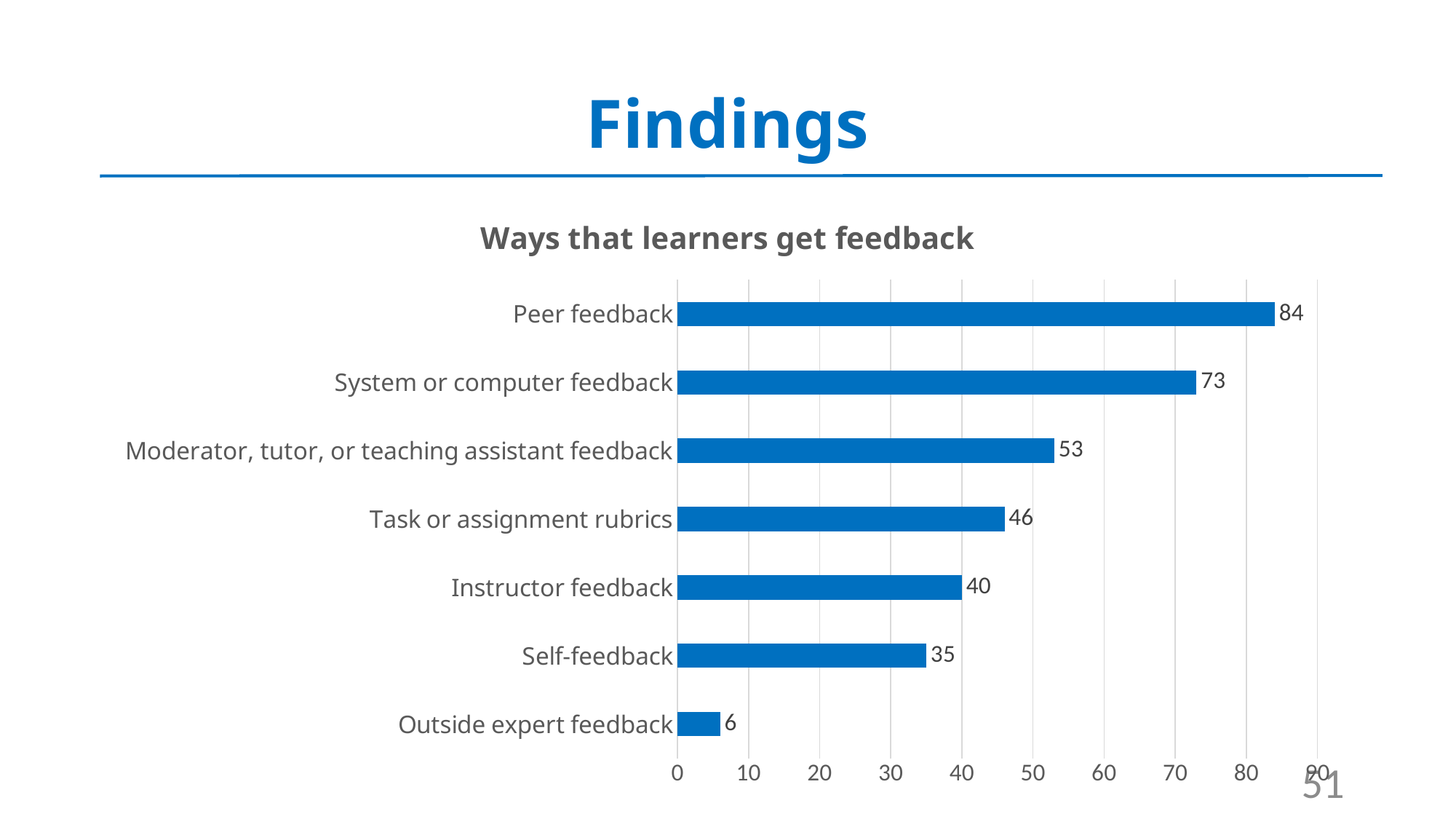
What is the difference between the values for Peer feedback and System or computer feedback? 11 What is the value for Self-feedback? 35 What is the value for Task or assignment rubrics? 46 What is the value for Peer feedback? 84 How many categories are shown in the chart? 7 What is the difference between the values for Instructor feedback and Outside expert feedback? 34 Is the value for System or computer feedback greater or less than 70? greater Which is larger, the value for Moderator, tutor, or teaching assistant feedback or the value for Instructor feedback? Moderator, tutor, or teaching assistant feedback What is the title of the chart? Ways that learners get feedback Which category has the lowest value? Outside expert feedback What kind of chart is shown on the slide? bar chart Which category has the highest value? Peer feedback